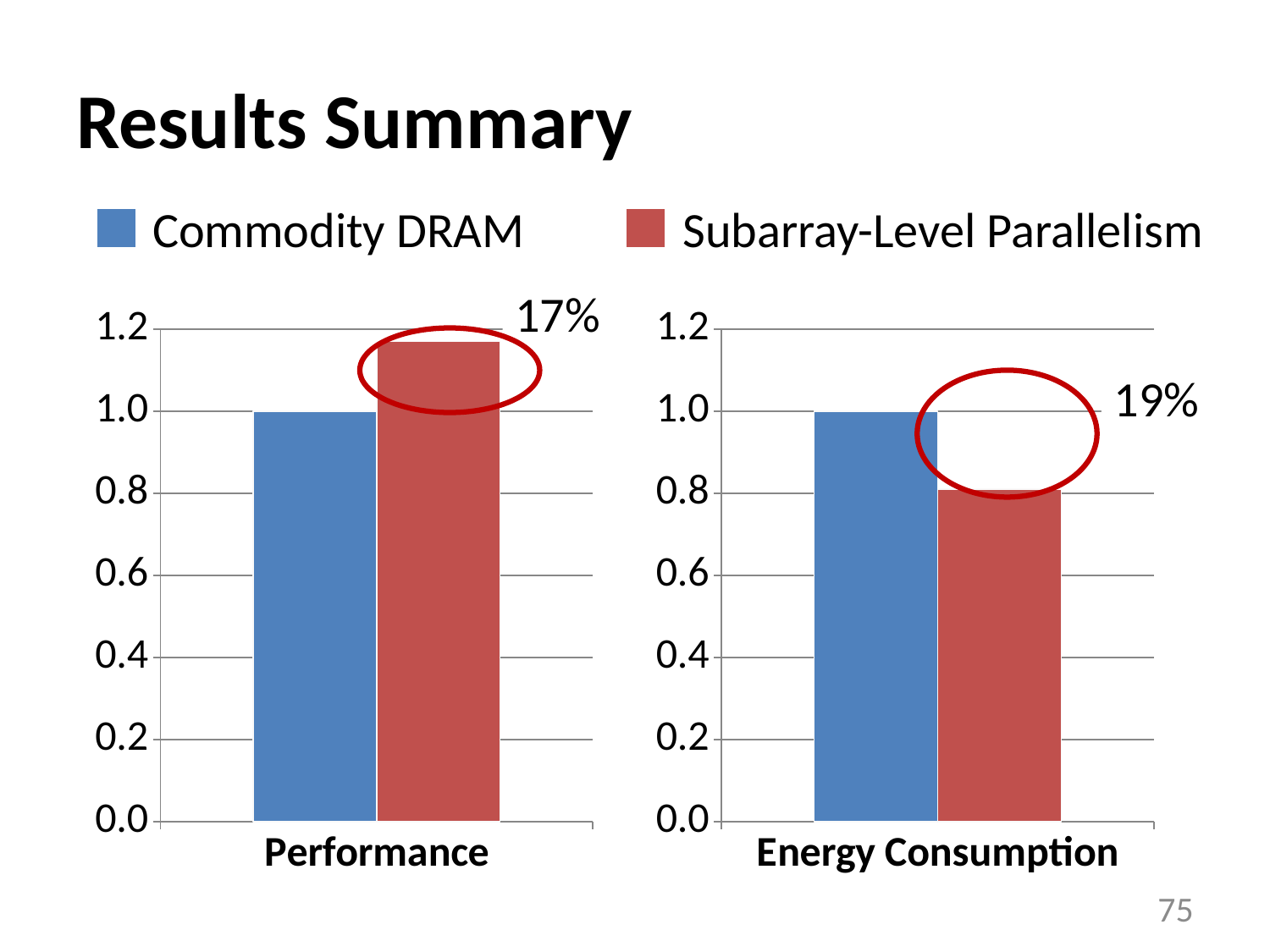
How many series does the legend list? 2 In the Energy Consumption chart, which series has the lower value? Subarray-Level Parallelism In the Performance chart, which series has the higher value? Subarray-Level Parallelism In the Performance chart, is the value for Subarray-Level Parallelism greater or less than 1.0? greater What percentage is annotated next to the circled bar in the Performance chart? 17% In the Energy Consumption chart, is the value for Subarray-Level Parallelism greater or less than 0.6? greater In the Energy Consumption chart, what is the value for Commodity DRAM? 1.0 In the Performance chart, what is the value for Commodity DRAM? 1.0 In the Energy Consumption chart, is the Commodity DRAM bar taller or shorter than the Subarray-Level Parallelism bar? taller In the Energy Consumption chart, is the value for Subarray-Level Parallelism greater or less than 1.0? less What percentage is annotated next to the circled area in the Energy Consumption chart? 19% What kind of chart is the Performance chart? bar chart